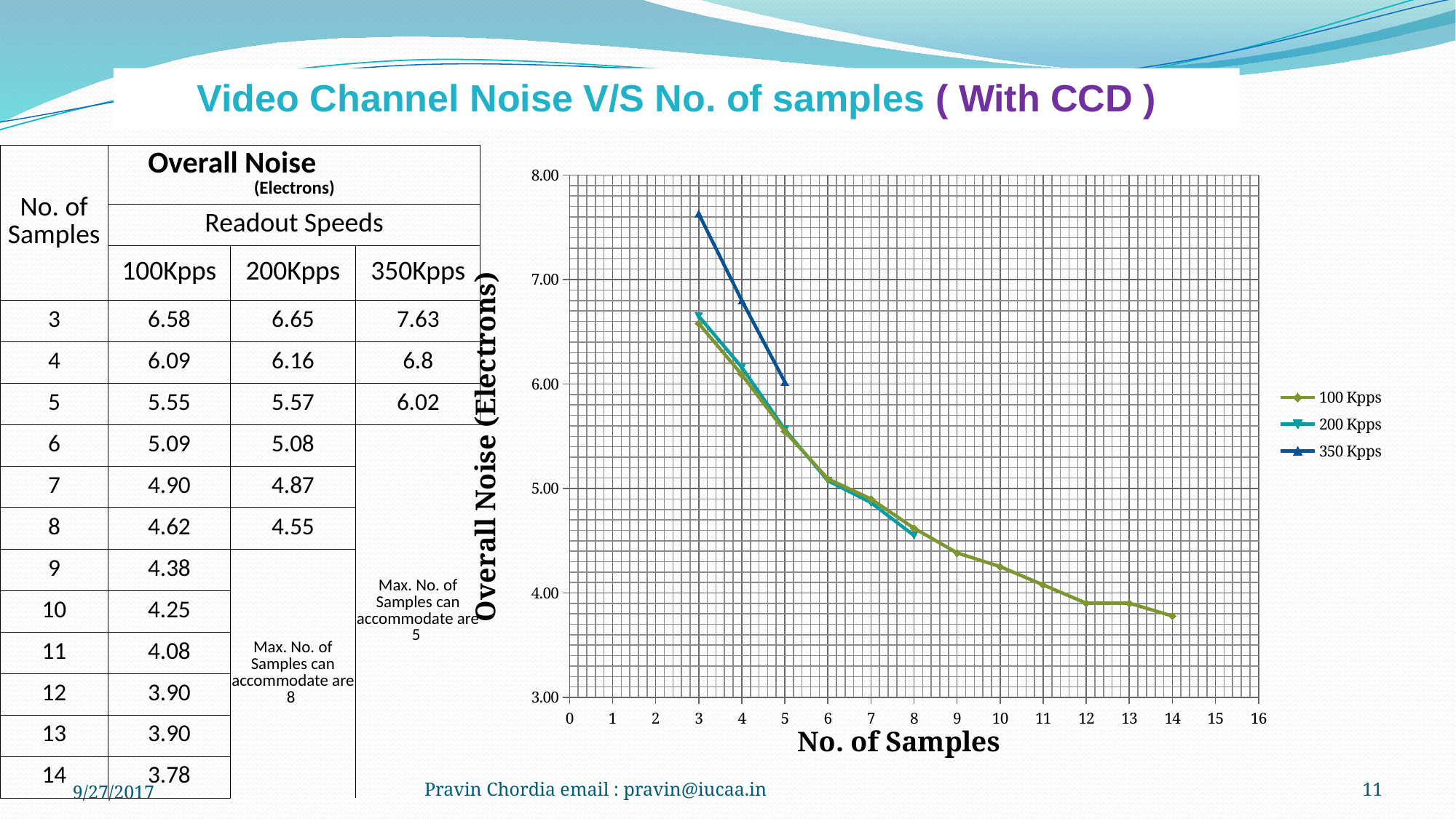
What kind of chart is shown on the slide? line chart Which series has the highest overall noise at 3 samples? 350 Kpps What is the difference between the 350 Kpps and 100 Kpps overall noise at 3 samples? 1.05 What is the overall noise for 100 Kpps at 14 samples? 3.78 How many data points are plotted for the 350 Kpps series? 3 What is the overall noise for 350 Kpps at 5 samples? 6.02 What is the title of the chart's x axis? No. of Samples Is the 350 Kpps value at 3 samples greater or less than 7.00? greater How many series does the chart legend list? 3 Is the 100 Kpps value at 14 samples greater or less than 4.00? less Do the overall noise values rise or fall as the number of samples increases? fall What are the three series named in the chart legend? 100 Kpps, 200 Kpps, 350 Kpps